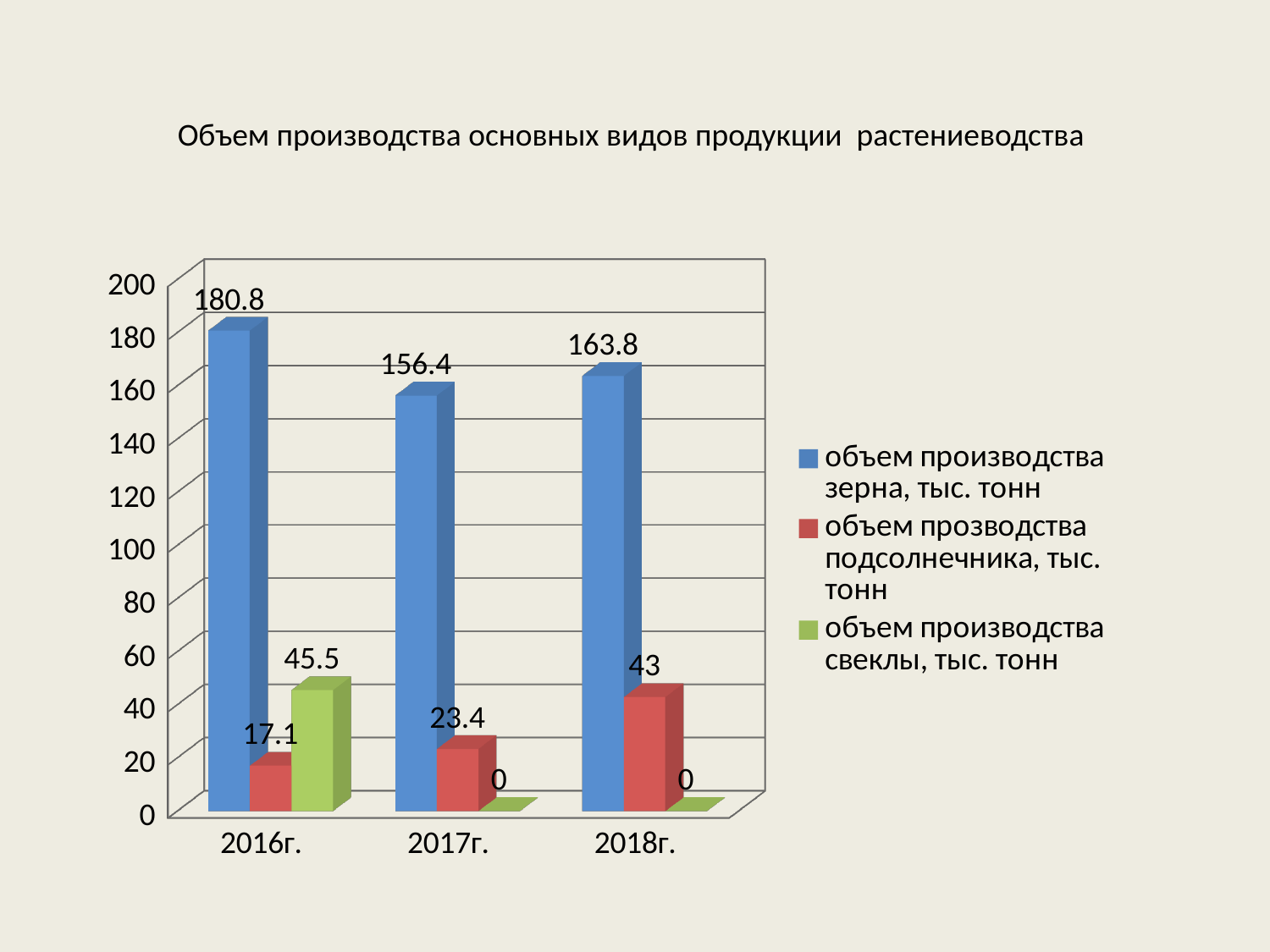
Which is larger: sunflower production in 2017г. or beet production in 2016г.? Beet production in 2016г. (45.5) Is grain production in 2018г. greater or less than 160? greater What is the volume of beet production (объем производства свеклы, тыс. тонн) in 2016г.? 45.5 How many years are shown on the x axis? 3 What is the volume of grain production (объем производства зерна, тыс. тонн) in 2016г.? 180.8 In which year is grain production (объем производства зерна) the highest? 2016г. How many series does the legend list? 3 What is the difference between grain production in 2016г. and 2017г.? 24.4 Does sunflower production (объем прозводства подсолнечника) rise or fall from 2016г. to 2018г.? Rises What is the volume of sunflower production (объем прозводства подсолнечника, тыс. тонн) in 2018г.? 43 In which year is sunflower production (объем прозводства подсолнечника) the lowest? 2016г. What kind of chart is shown on the slide? Bar chart